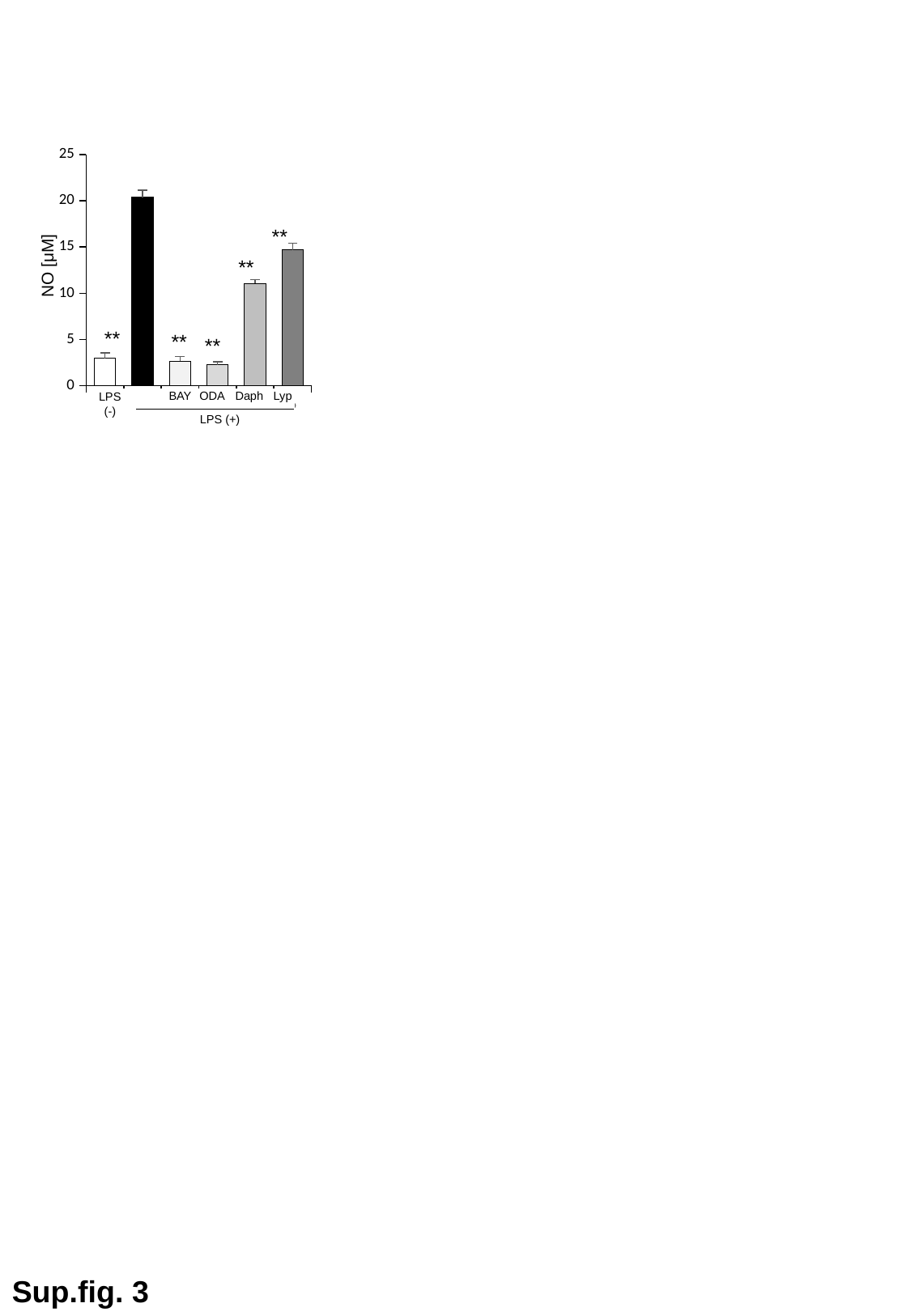
Which is larger, the value for Daph or the value for Lyp? Lyp What is the highest tick value shown on the y-axis? 25 Which is larger, the value for ODA or the value for Daph? Daph What kind of chart is shown on the slide? bar chart What is the label of the y-axis? NO [µM] Is the value for BAY greater or less than 5? less How many bars are plotted in the chart? 6 Which of the labelled inhibitor bars (BAY, ODA, Daph, Lyp) has the highest value? Lyp Is the value for LPS (-) greater or less than 5? less Is the value for Daph greater or less than 10? greater